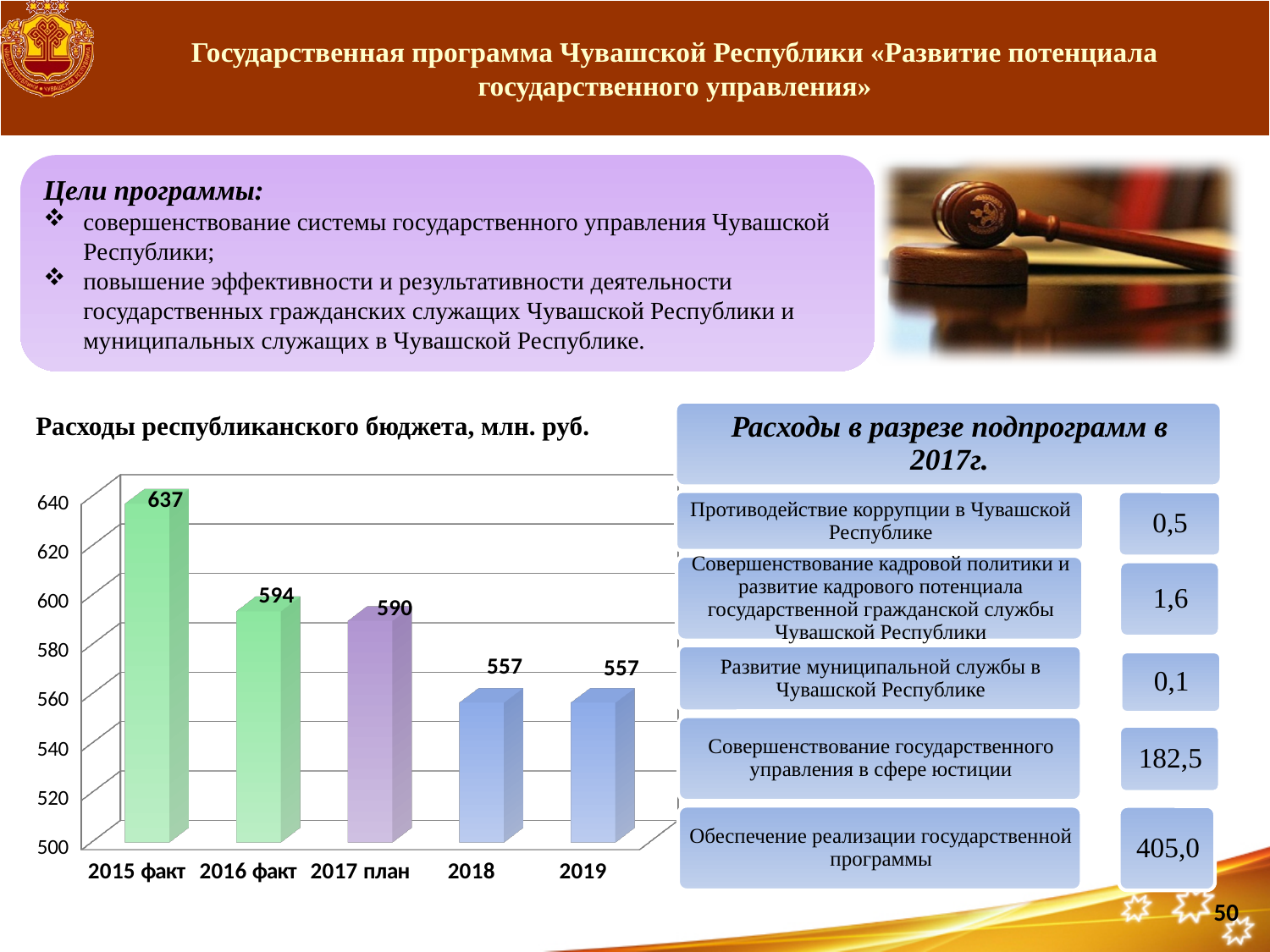
Is the value for 2016 факт greater or less than 580 in the chart 'Расходы республиканского бюджета, млн. руб.'? greater What is the value for 2019 in the chart 'Расходы республиканского бюджета, млн. руб.'? 557 How many categories are shown on the x axis of the chart 'Расходы республиканского бюджета, млн. руб.'? 5 What is the difference between the values for 2015 факт and 2016 факт in the chart 'Расходы республиканского бюджета, млн. руб.'? 43 What is the value for 2017 план in the chart 'Расходы республиканского бюджета, млн. руб.'? 590 What is the value for 2015 факт in the chart 'Расходы республиканского бюджета, млн. руб.'? 637 Which category has the highest value in the chart 'Расходы республиканского бюджета, млн. руб.'? 2015 факт What is the difference between the values for 2017 план and 2018 in the chart 'Расходы республиканского бюджета, млн. руб.'? 33 What kind of chart is 'Расходы республиканского бюджета, млн. руб.'? bar chart Which is larger in the chart 'Расходы республиканского бюджета, млн. руб.': the value for 2016 факт or the value for 2018? 2016 факт What is the title of the bar chart on the slide? Расходы республиканского бюджета, млн. руб. Do the values in the chart 'Расходы республиканского бюджета, млн. руб.' generally rise or fall from 2015 факт to 2019? fall